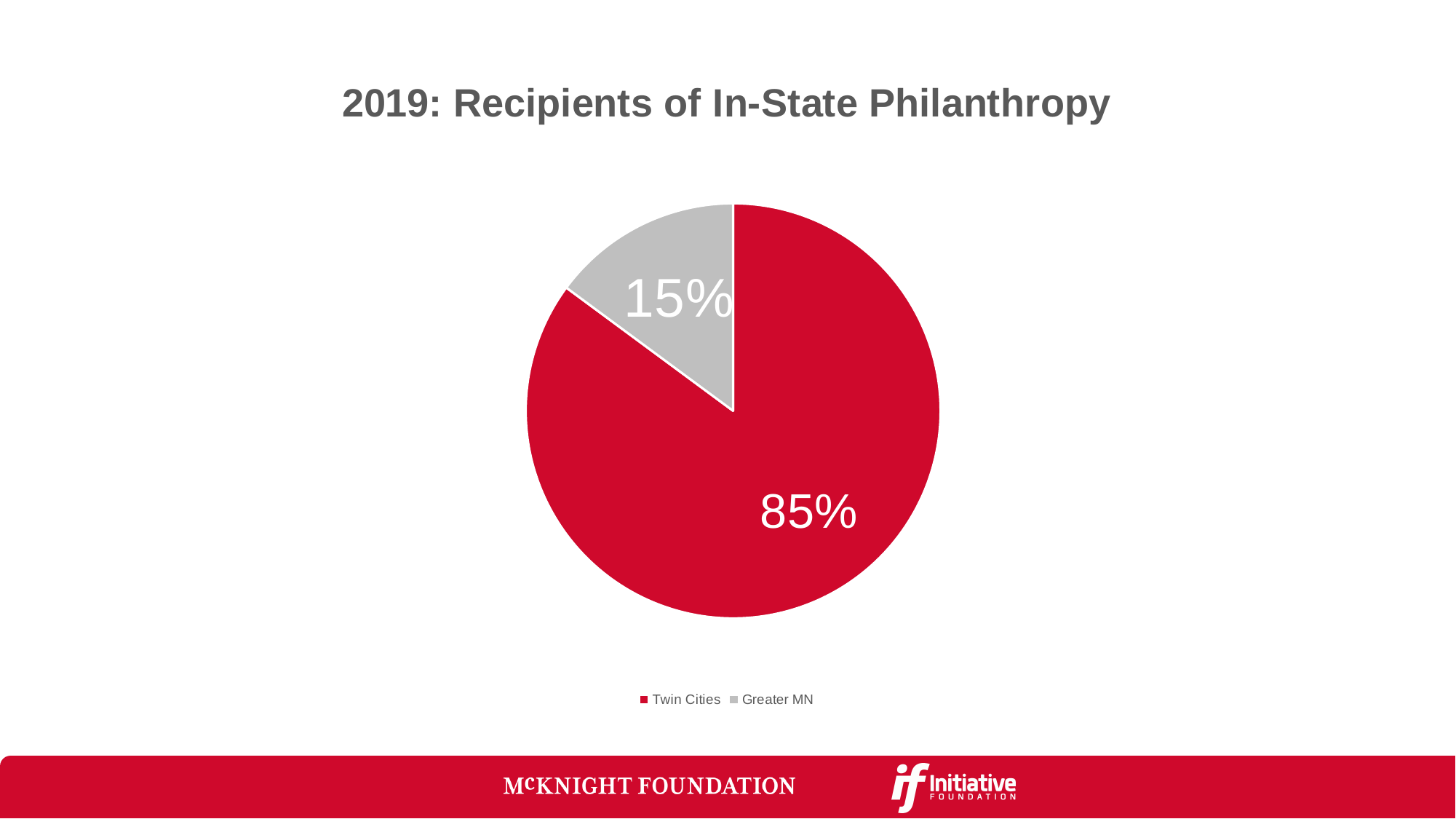
What is the difference in percentage points between the Twin Cities share and the Greater MN share? 70 Which received a larger share of in-state philanthropy, Twin Cities or Greater MN? Twin Cities Which category received the largest share of in-state philanthropy? Twin Cities What share of in-state philanthropy recipients were in the Twin Cities? 85% Which category received the smallest share of in-state philanthropy? Greater MN What colour is the Greater MN slice? Grey What share of in-state philanthropy recipients were in Greater MN? 15% How many categories does the pie chart show? 2 What kind of chart is shown on the slide? Pie chart What is the title of the chart? 2019: Recipients of In-State Philanthropy What is the combined share of the Twin Cities and Greater MN slices? 100%